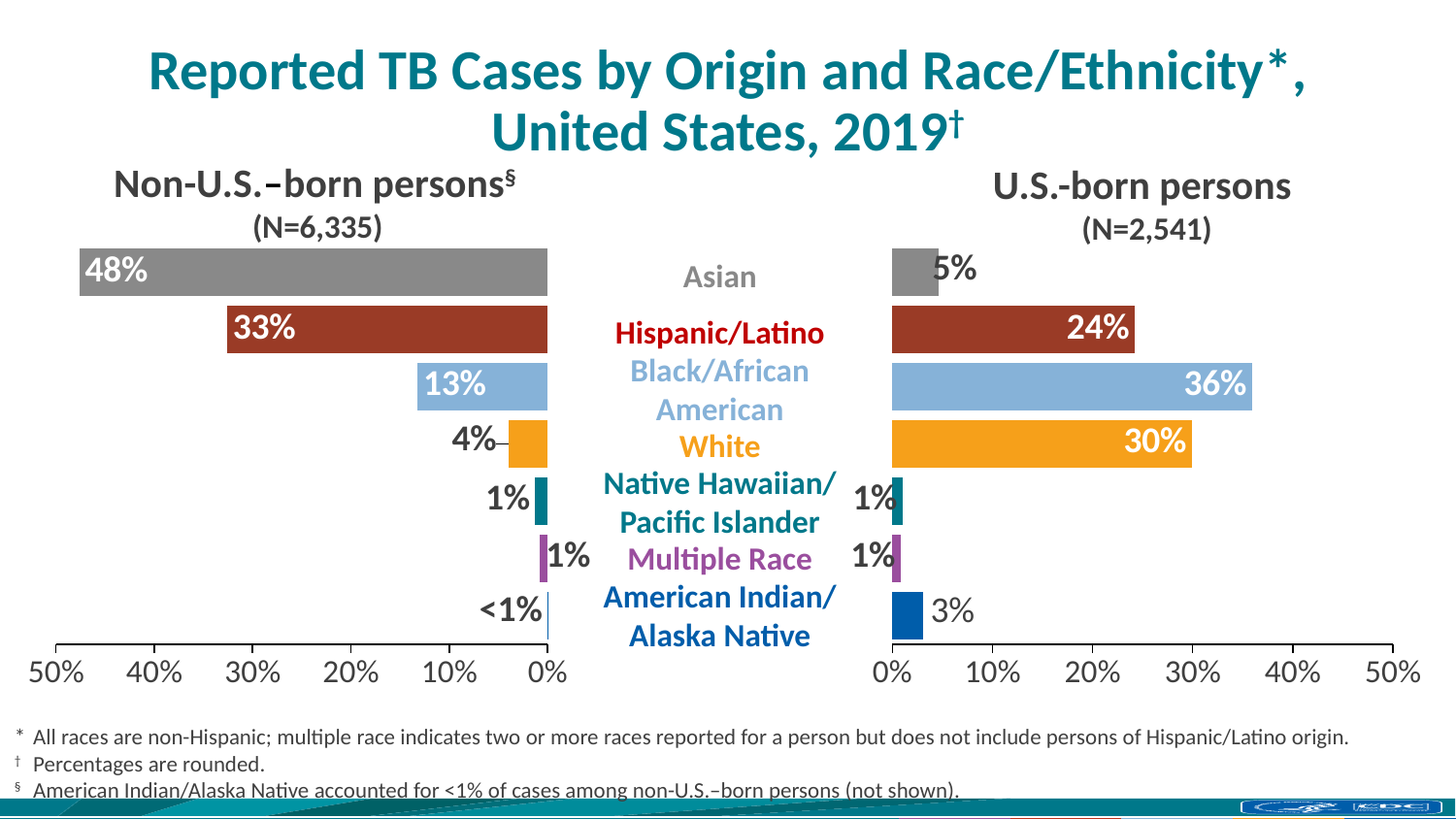
In the U.S.-born persons chart, what percentage of reported TB cases were among Black/African American persons? 36% In the U.S.-born persons chart, which race/ethnicity group has the lowest percentage of cases? Native Hawaiian/Pacific Islander and Multiple Race (1% each) In the U.S.-born persons chart, what is the difference in percentage points between Black/African American and Hispanic/Latino persons? 12 percentage points In the Non-U.S.-born persons chart, what is the difference in percentage points between Asian and Hispanic/Latino persons? 15 percentage points In the Non-U.S.-born persons chart, what percentage of cases were among Hispanic/Latino persons? 33% In the Non-U.S.-born persons chart, which race/ethnicity group has the highest percentage of cases? Asian Which is larger: the percentage for White persons among Non-U.S.-born persons or among U.S.-born persons? U.S.-born persons In the U.S.-born persons chart, what percentage of cases were among White persons? 30% In the Non-U.S.-born persons chart, what percentage of reported TB cases were among Asian persons? 48% How many race/ethnicity categories are shown in the U.S.-born persons chart? 7 What type of chart is used to show the Non-U.S.-born persons data? Bar chart What is the total number of cases (N) shown for Non-U.S.-born persons? N=6,335